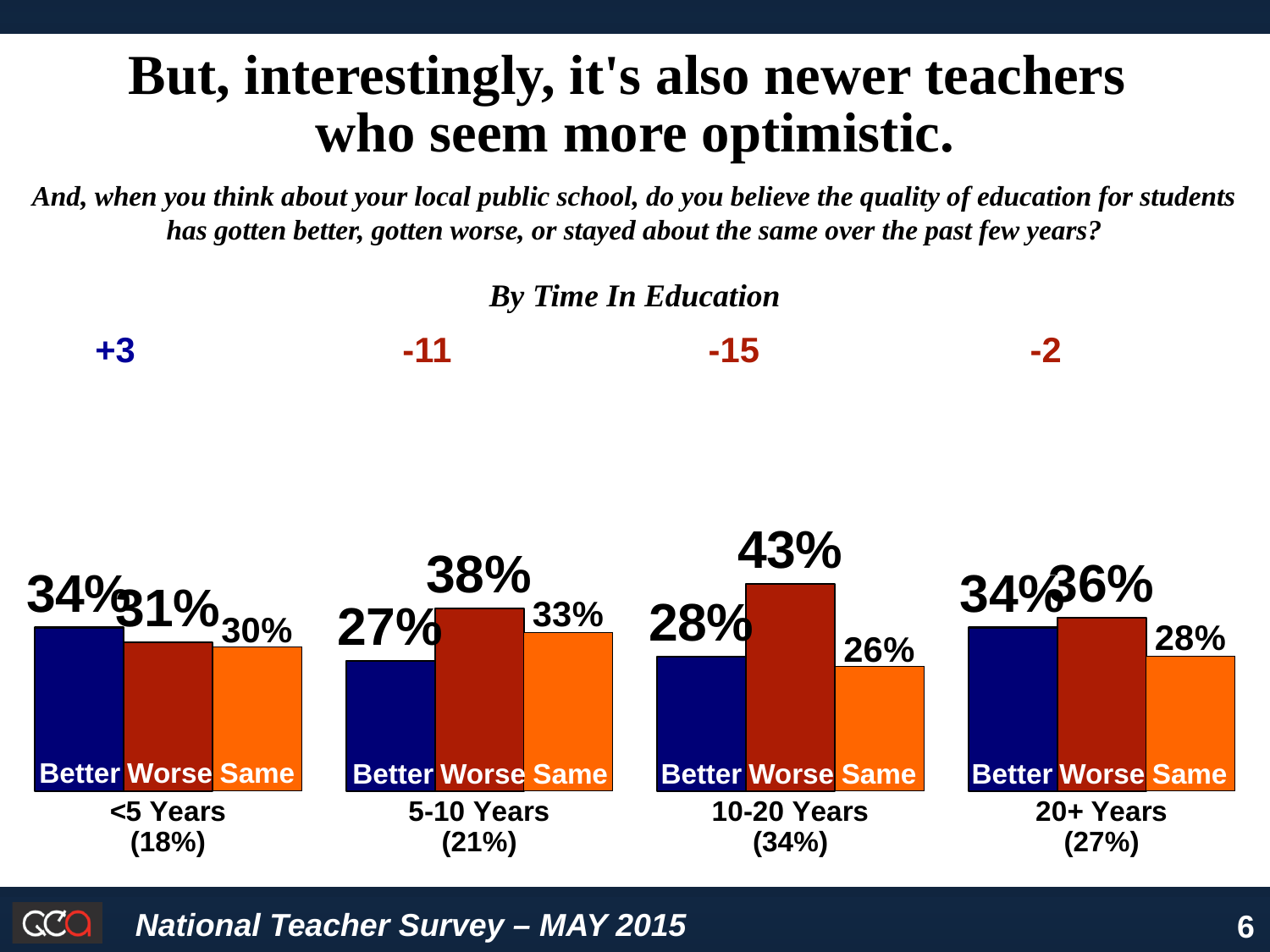
In the 10-20 Years chart, what is the difference between the Worse and Better values? 15 percentage points In the 20+ Years chart, which is larger, the value for Worse or the value for Same? Worse In the <5 Years chart, what percentage of teachers said the quality of education has gotten better? 34% In the 10-20 Years chart, which response has the highest value? Worse In the 5-10 Years chart, what is the difference between the Worse and Same values? 5 percentage points What kind of chart is used to show the responses for each time-in-education group? Bar chart In the 5-10 Years chart, what is the value for Same? 33% In the 10-20 Years chart, what is the value for Worse? 43% How many bars are shown in each of the four charts? 3 What share of respondents does the 10-20 Years group represent, as shown under its chart? 34% In the 5-10 Years chart, which response has the lowest value? Better In the 20+ Years chart, what is the value for Better? 34%